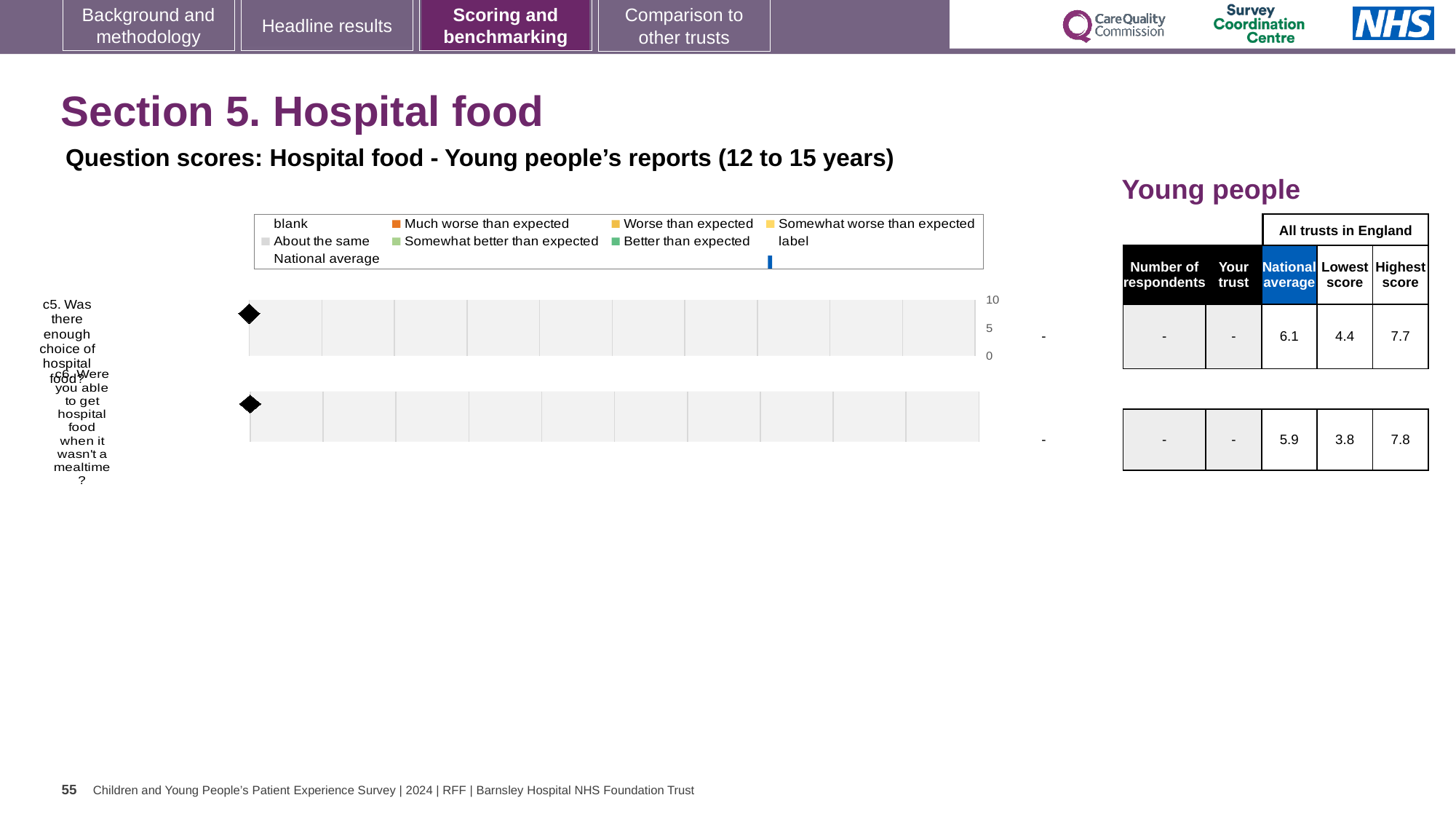
What value is shown for 'Your trust' for c5? - What is the national average score for c5 (Was there enough choice of hospital food?)? 6.1 Which question has the higher national average, c5 or c6? c5 What colour is the legend marker for 'Much worse than expected'? orange What is the difference between the highest and lowest score for c6? 4.0 Which question has the lower 'Lowest score' value, c5 or c6? c6 How many questions (categories) are plotted on the chart? 2 What kind of chart is shown on the slide? bar chart What is the maximum value shown on the chart's score axis? 10 What is the difference between the highest and lowest score for c5? 3.3 What is the highest score across all trusts in England for c6 (Were you able to get hospital food when it wasn't a mealtime?)? 7.8 What is the lowest score across all trusts in England for c5? 4.4